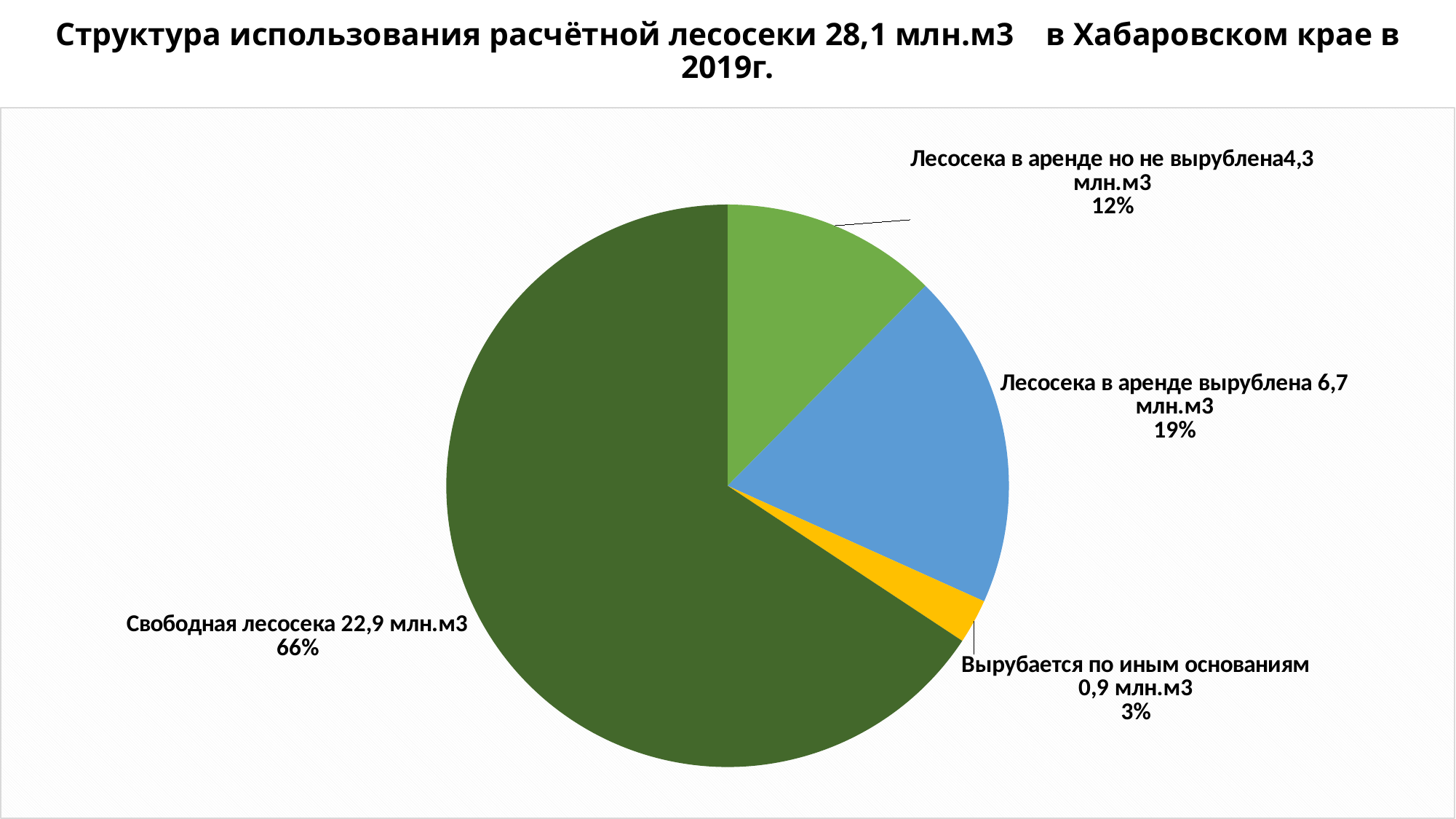
Which category has the largest slice? Свободная лесосека Which is larger: the slice for "Лесосека в аренде вырублена" or the slice for "Лесосека в аренде но не вырублена"? Лесосека в аренде вырублена What is the volume for "Свободная лесосека"? 22,9 млн.м3 How many slices does the pie chart have? 4 What share of the pie does "Свободная лесосека" take? 66% What share of the pie does "Лесосека в аренде вырублена" take? 19% What kind of chart is shown on the slide? pie chart What share of the pie does "Вырубается по иным основаниям" take? 3% What is the volume for "Лесосека в аренде вырублена"? 6,7 млн.м3 Which category has the smallest slice? Вырубается по иным основаниям What is the difference in volume between "Лесосека в аренде вырублена" and "Лесосека в аренде но не вырублена"? 2,4 млн.м3